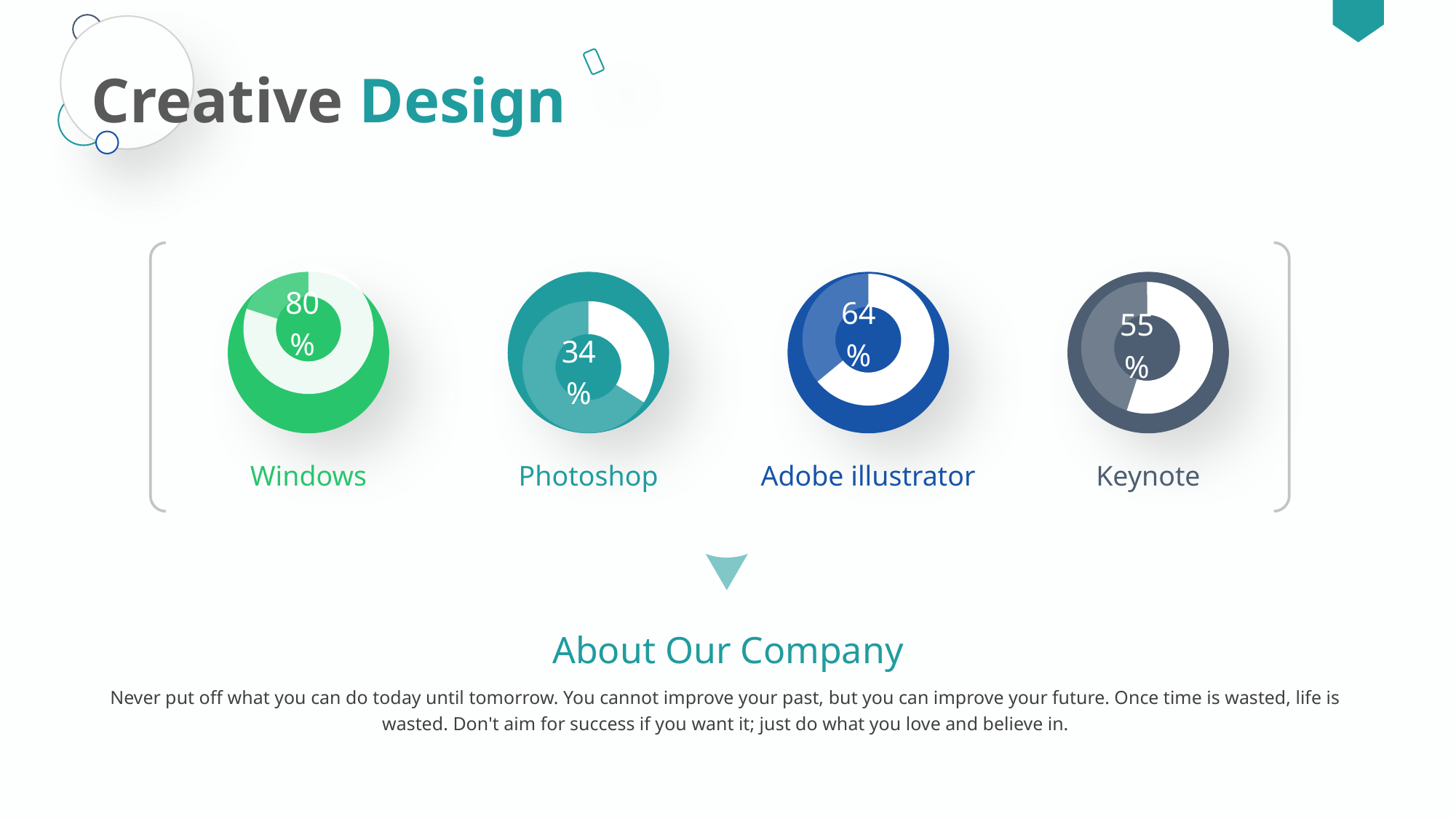
Which shows a larger percentage, the Adobe illustrator chart or the Keynote chart? Adobe illustrator Across the four donut charts, which one shows the highest percentage? Windows What percentage is shown on the Photoshop chart? 34% What percentage is shown on the Keynote chart? 55% What colour is the Adobe illustrator donut chart? Blue What is the difference between the Adobe illustrator chart's percentage and the Keynote chart's percentage? 9% How many donut charts are shown on the slide? 4 What is the difference between the Windows chart's percentage and the Photoshop chart's percentage? 46% What percentage is shown on the Adobe illustrator chart? 64% What kind of chart is used for the Windows value? Donut chart What percentage is shown on the Windows chart? 80% Across the four donut charts, which one shows the lowest percentage? Photoshop